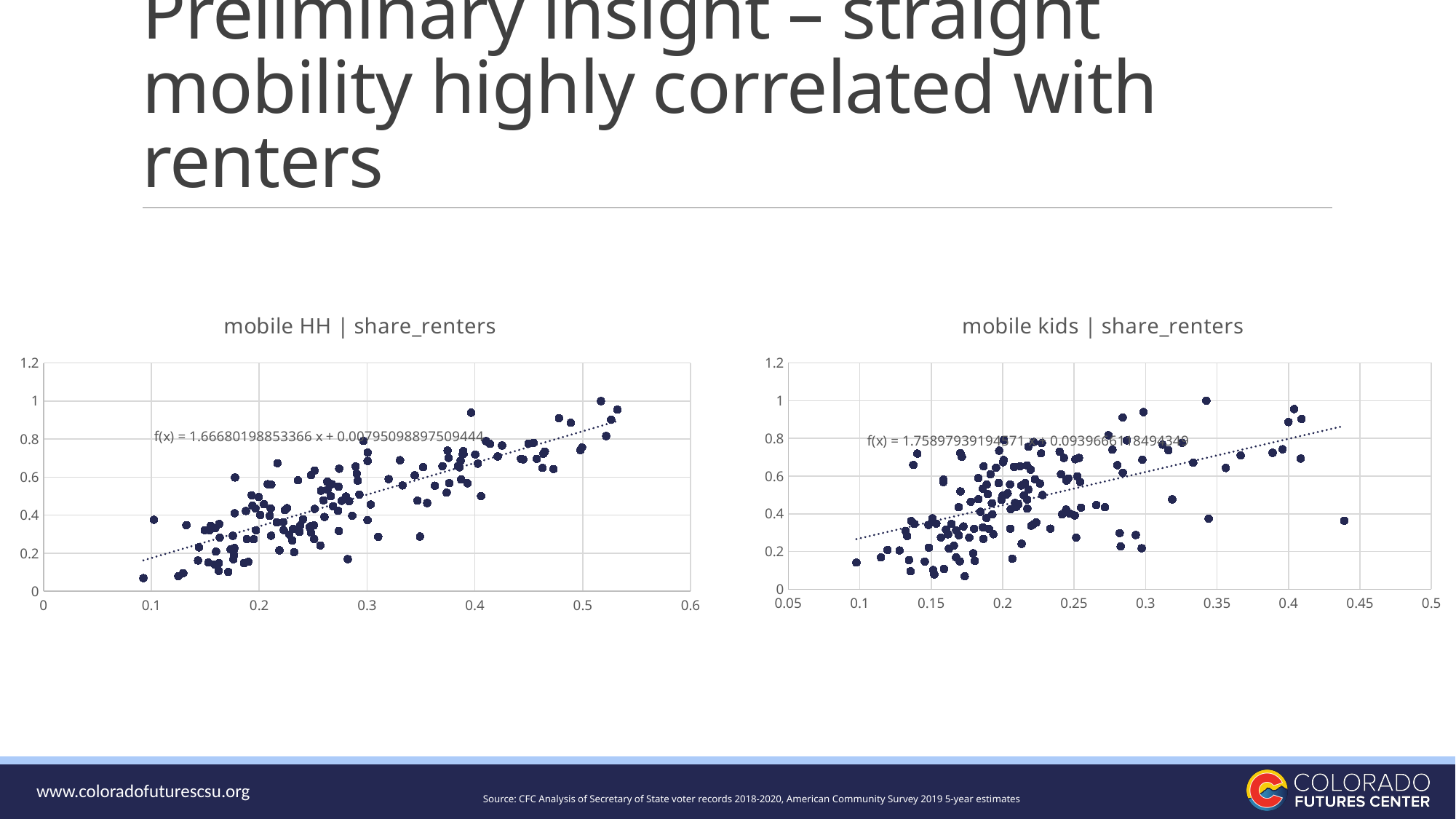
What is the title of the right chart? mobile kids | share_renters In the right chart "mobile kids | share_renters", what is the lowest value shown on the x axis? 0.05 In the left chart "mobile HH | share_renters", do the plotted values generally rise or fall as the x value increases? rise In the left chart "mobile HH | share_renters", is the y value of the leftmost point (near x = 0.1) greater or less than 0.2? less In the right chart "mobile kids | share_renters", is the y value of the rightmost point (near x = 0.44) greater or less than 0.6? less How many charts are shown on the slide? 2 In the right chart "mobile kids | share_renters", does the dotted trendline rise or fall from left to right? rise In the right chart "mobile kids | share_renters", what is the slope coefficient shown in the printed trendline equation? 1.75897939194971 In the left chart "mobile HH | share_renters", is the highest plotted point greater or less than 0.8 on the y axis? greater In the left chart "mobile HH | share_renters", what trendline equation is printed? f(x) = 1.66680198853366 x + 0.00795098897509444 In the left chart "mobile HH | share_renters", what is the highest value shown on the x axis? 0.6 What kind of chart is the left chart titled "mobile HH | share_renters"? scatter chart